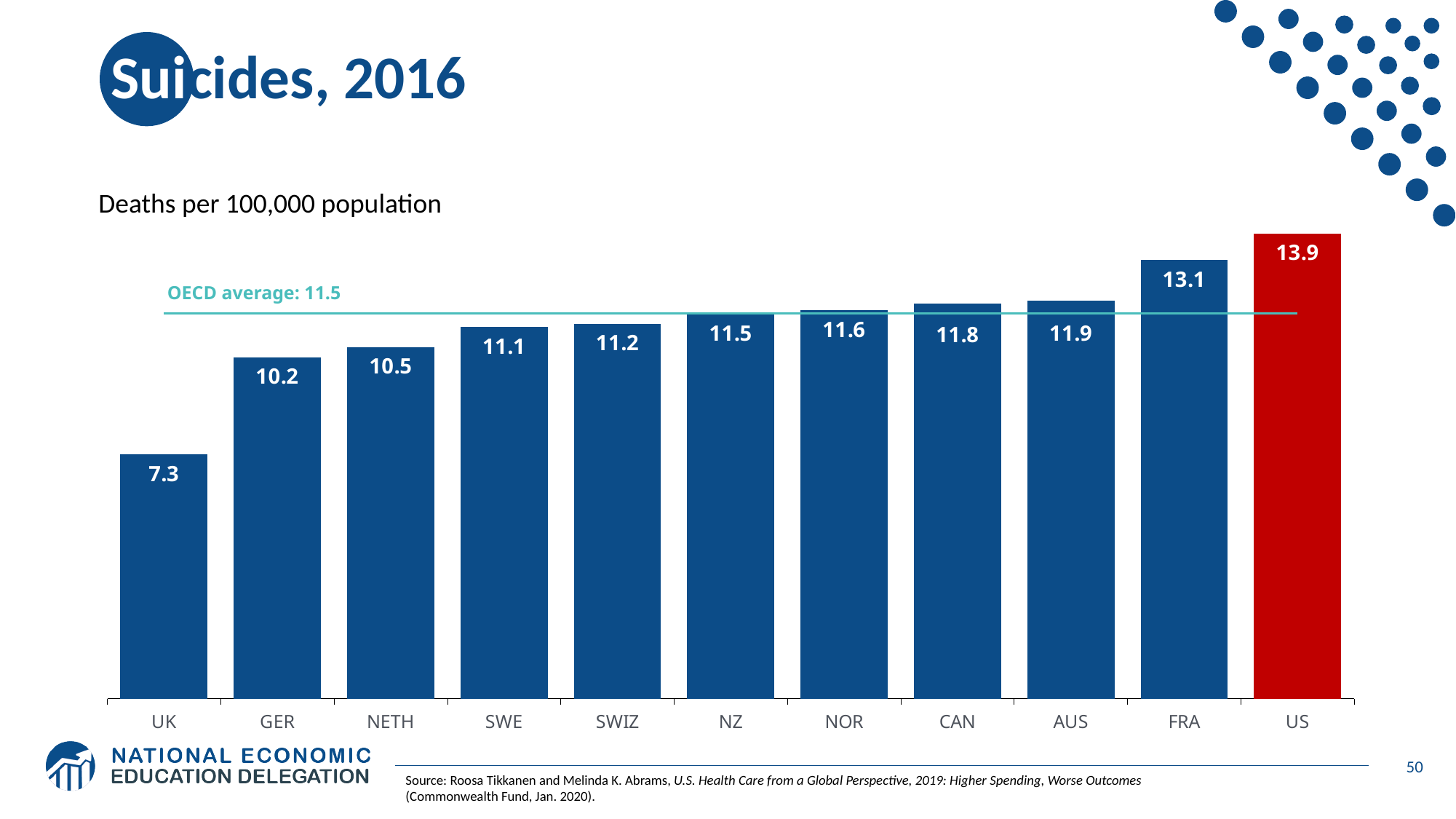
What is the difference between the US value and the UK value? 6.6 Which country has the lowest value on the chart? UK What is the difference between the FRA value and the AUS value? 1.2 Which country has the highest value on the chart? US What is the value shown for NOR? 11.6 What is the value shown for GER? 10.2 What is the suicide rate shown for the US? 13.9 What kind of chart is shown on the slide? Bar chart What OECD average value is marked by the horizontal line on the chart? 11.5 How many countries are shown on the chart? 11 Do the values rise or fall moving from left to right across the chart? Rise Which has a higher value, SWE or CAN? CAN